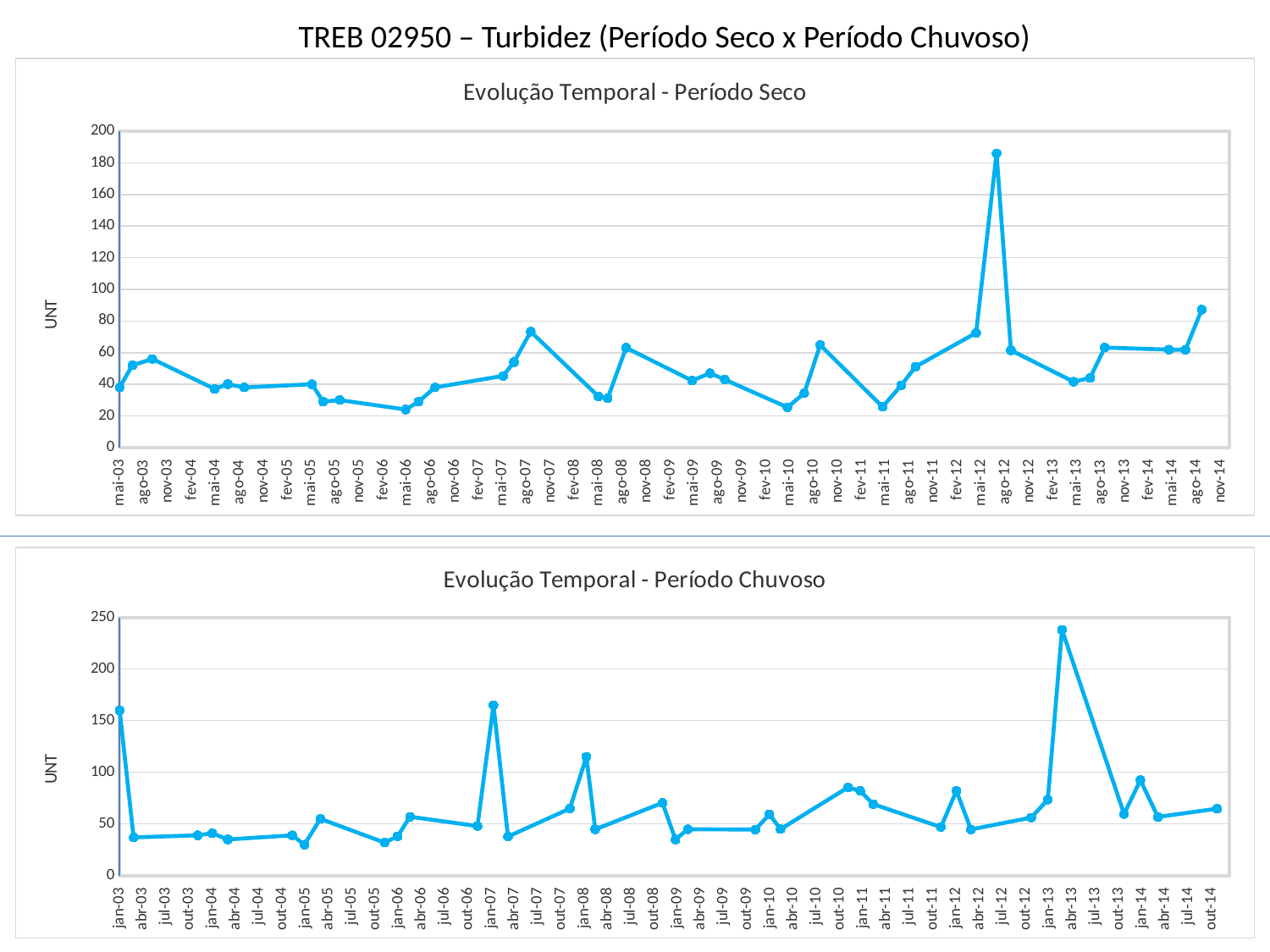
What type of chart is 'Evolução Temporal - Período Seco'? Line chart In the 'Evolução Temporal - Período Seco' chart, is the value at mai-06 greater or less than 40? less In the 'Evolução Temporal - Período Seco' chart, at which date does the line reach its highest value? ago-12 In the 'Evolução Temporal - Período Chuvoso' chart, is the peak value at abr-13 greater or less than 200? greater In the 'Evolução Temporal - Período Chuvoso' chart, at which date does the line reach its highest value? abr-13 In the 'Evolução Temporal - Período Seco' chart, which is larger: the value at ago-12 or the value at ago-07? ago-12 In the 'Evolução Temporal - Período Chuvoso' chart, which is larger: the value at abr-13 or the value at jan-07? abr-13 In the 'Evolução Temporal - Período Seco' chart, is the peak value at ago-12 greater or less than 160? greater What is the label on the vertical axis of both charts? UNT What type of chart is 'Evolução Temporal - Período Chuvoso'? Line chart